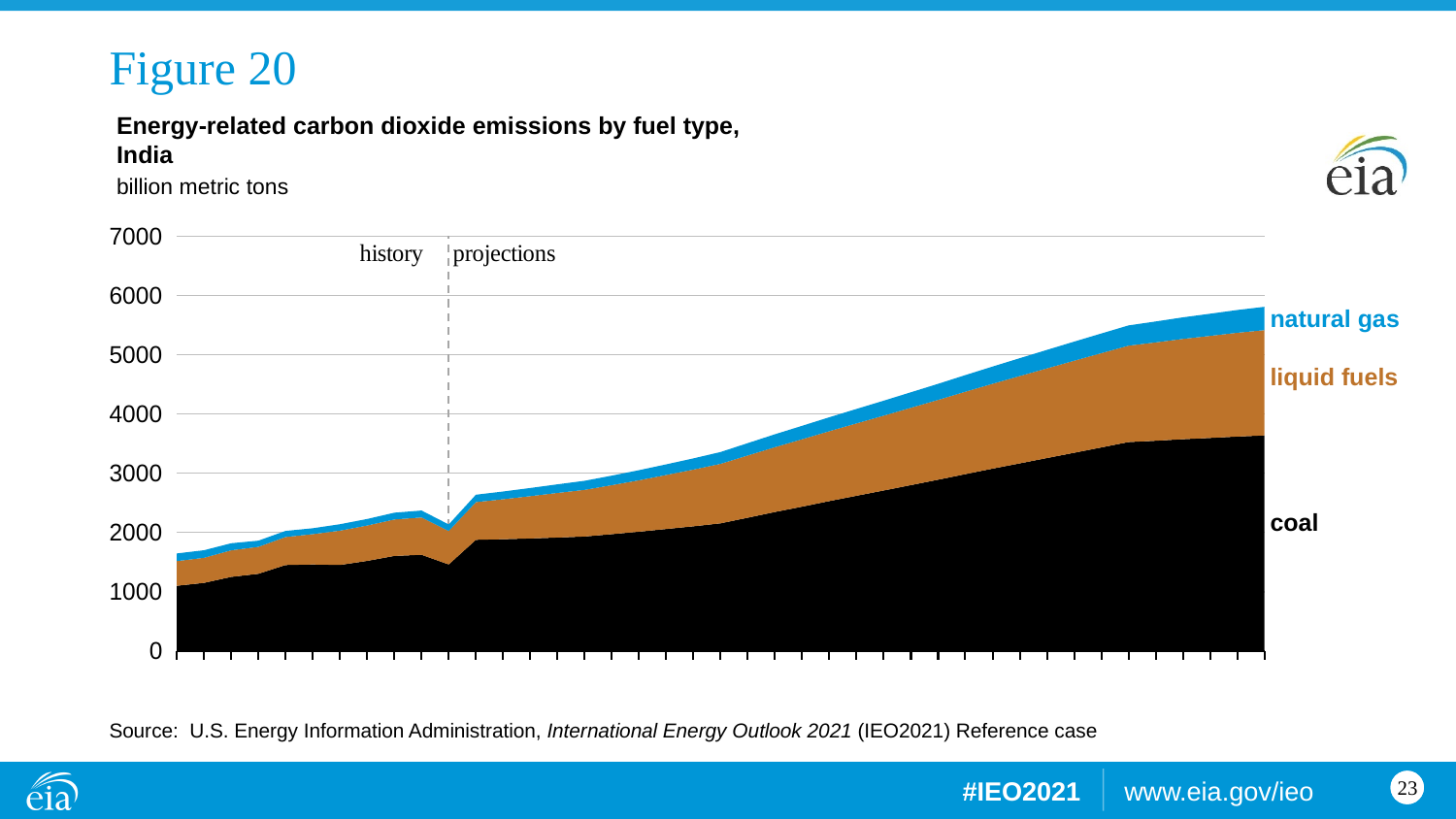
At the right end of the chart, are total emissions (top of the stacked area) greater or less than 6000 billion metric tons? less Which fuel type accounts for the largest share of India's energy-related carbon dioxide emissions throughout the chart? coal What two labels separate the left and right portions of the chart at the dashed vertical line? history and projections At the right end of the chart, are emissions from coal greater or less than 3000 billion metric tons? greater Do total energy-related carbon dioxide emissions for India generally rise or fall from left to right across the chart? rise Which fuel type accounts for the smallest share of India's energy-related carbon dioxide emissions throughout the chart? natural gas At the right end of the chart, which is larger: emissions from coal or emissions from natural gas? coal What unit is used for the values on the chart's vertical axis? billion metric tons What kind of chart is shown on the slide? stacked area chart How many fuel types (series) are shown in the chart? 3 At the left end of the chart, are total emissions (top of the stacked area) greater or less than 2000 billion metric tons? less